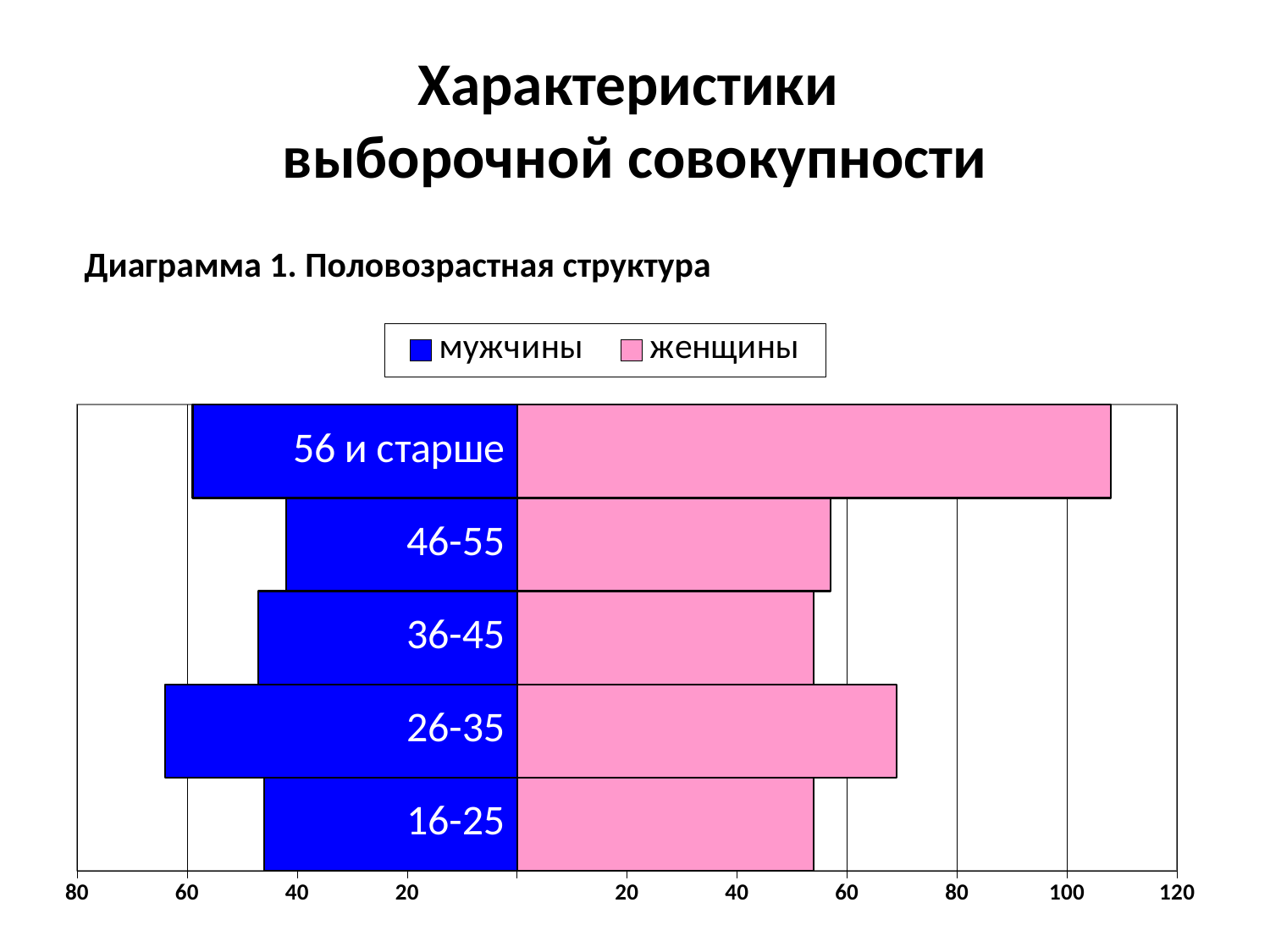
Is the value for мужчины in the 46-55 category greater or less than 60? less What is the caption of the chart on the slide? Диаграмма 1. Половозрастная структура Is the value for женщины in the 26-35 category greater or less than 60? greater In the 56 и старше category, which series has the larger value, мужчины or женщины? женщины For мужчины, which is larger: the value for 26-35 or the value for 36-45? 26-35 How many series does the legend list? 2 How many age categories are plotted on the chart? 5 Which age category has the highest value for мужчины? 26-35 Which age category has the highest value for женщины? 56 и старше What kind of chart is shown on the slide? bar chart Is the value for женщины in the 56 и старше category greater or less than 100? greater